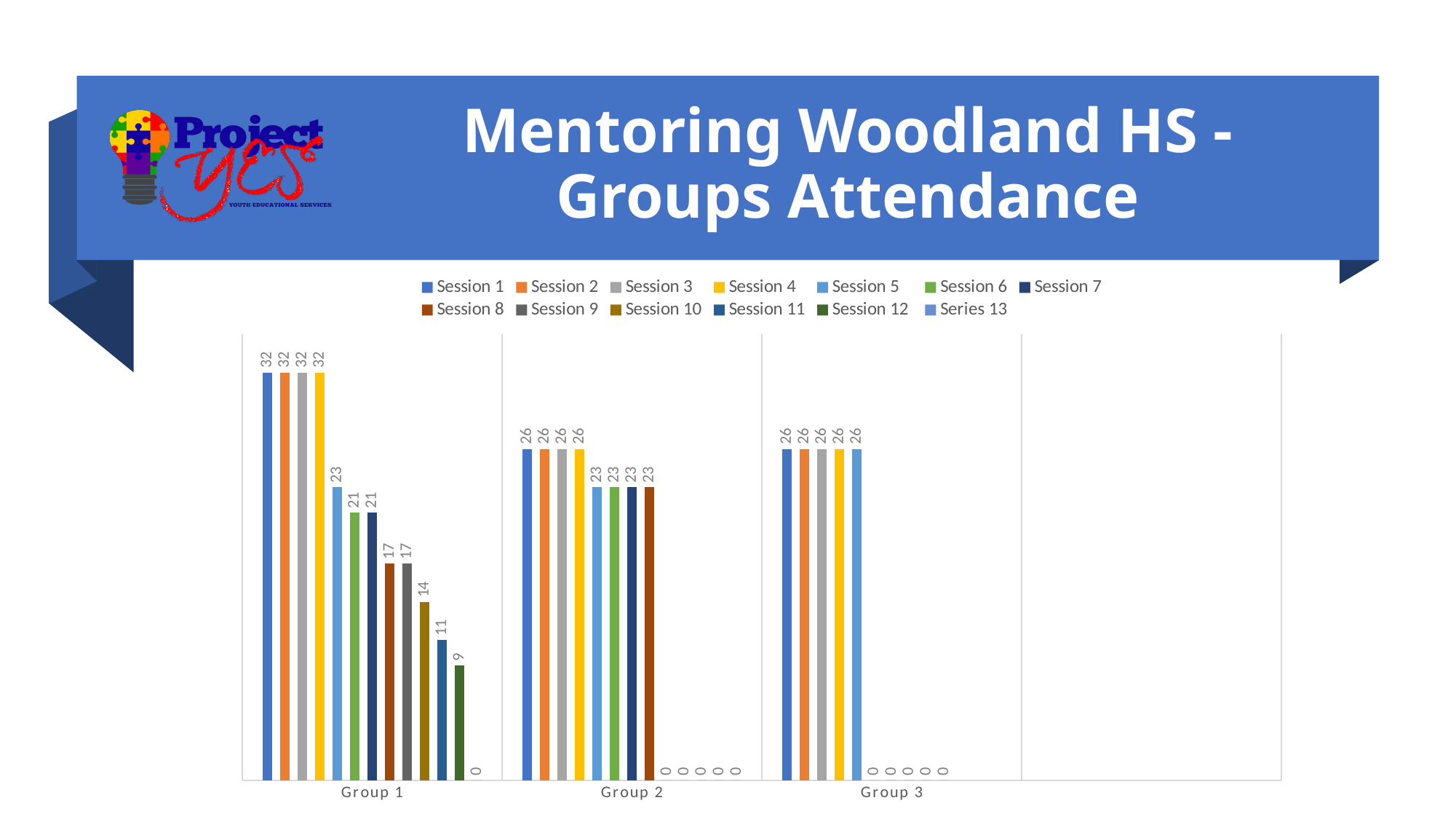
What is the value for Session 12 in Group 1? 9 How many series does the legend list? 13 What is the title of the chart? Mentoring Woodland HS - Groups Attendance Which group has the highest value for Session 1? Group 1 What is the difference between Session 1 and Session 12 in Group 1? 23 Which is larger in Group 1: Session 10 or Session 11? Session 10 Do the values for Group 1 rise or fall from Session 1 to Session 12? fall What type of chart is shown on the slide? bar chart What is the value for Session 1 in Group 1? 32 What is the value for Session 8 in Group 2? 23 What is the value for Session 5 in Group 3? 26 What is the value for Session 5 in Group 1? 23